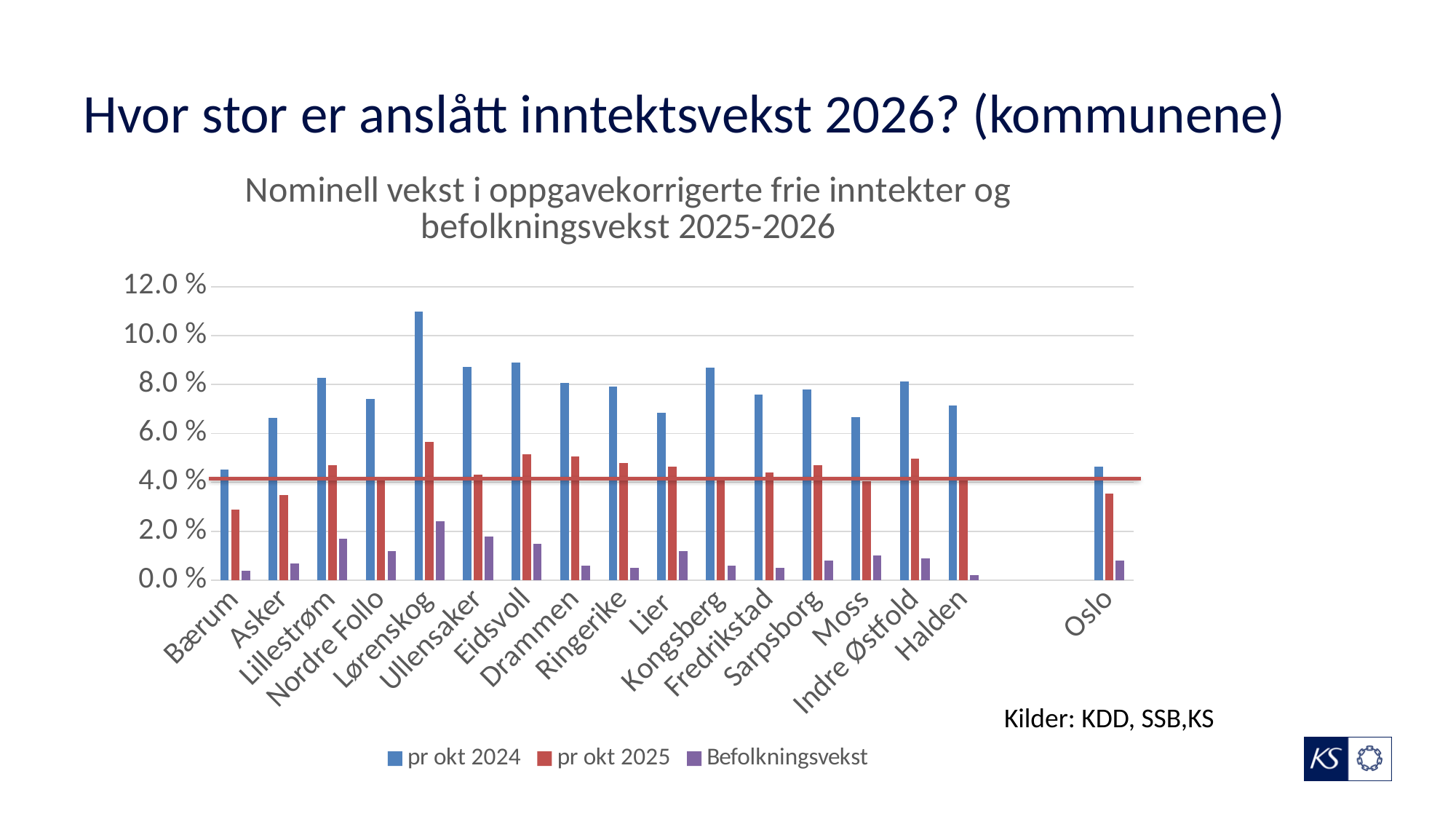
Which is larger, the pr okt 2024 value for Lillestrøm or for Nordre Follo? Lillestrøm Is the pr okt 2024 value for Lørenskog greater or less than 10.0 %? greater Which is larger, the pr okt 2025 value for Bærum or for Asker? Asker Which municipality has the highest value for pr okt 2024? Lørenskog Is the pr okt 2025 value for Bærum greater or less than 4.0 %? less Is the pr okt 2024 value for Eidsvoll greater or less than 8.0 %? greater Which municipality has the lowest value for Befolkningsvekst? Halden What kind of chart is shown on the slide? bar chart Which municipality has the highest value for Befolkningsvekst? Lørenskog Which series is shown in purple in the legend? Befolkningsvekst How many series does the legend list? 3 How many municipalities are shown on the x axis? 17